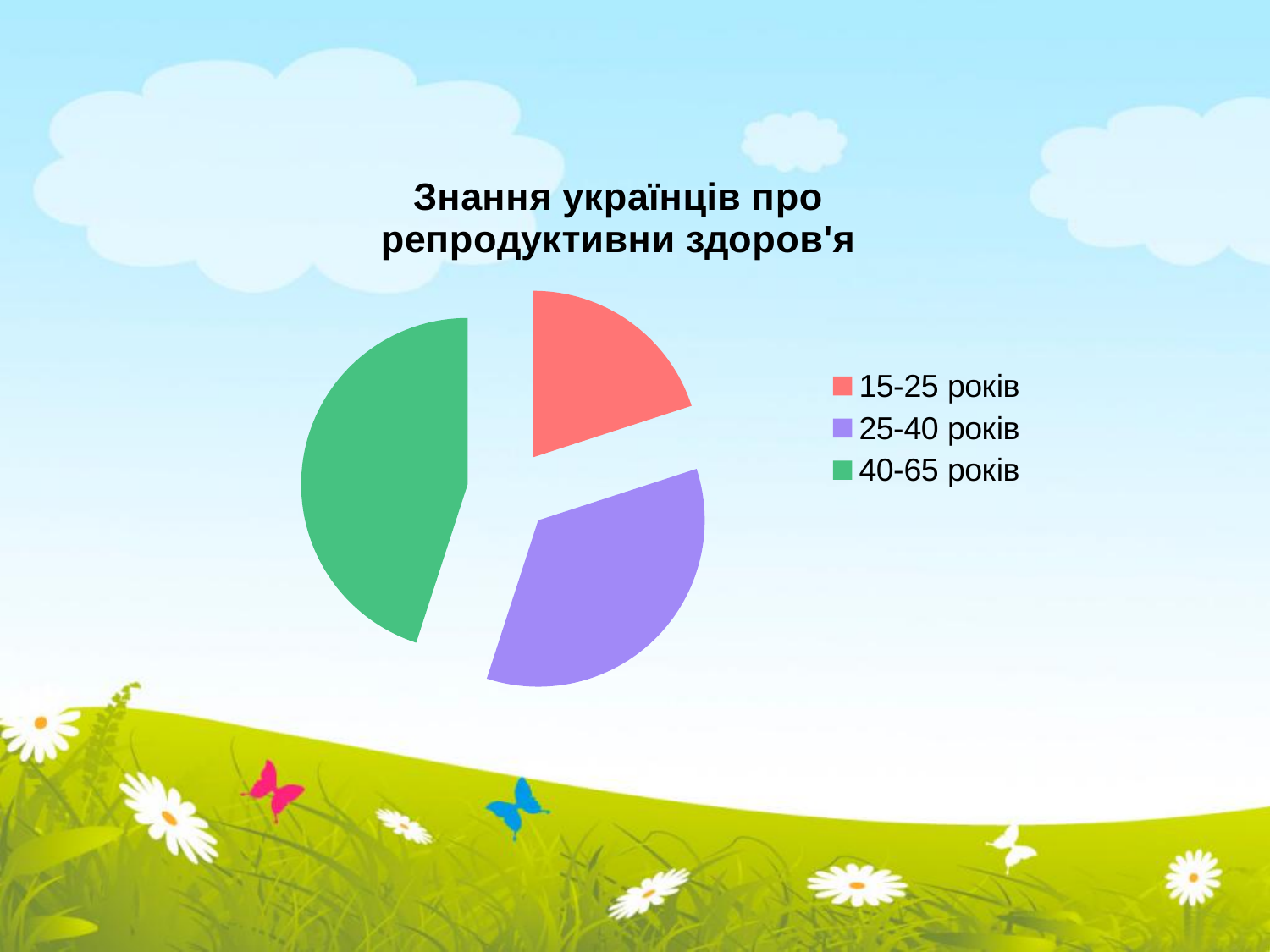
Which slice is larger, 15-25 років or 25-40 років? 25-40 років Which age group has the largest slice of the pie? 40-65 років Which age group has the smallest slice of the pie? 15-25 років Which slice is larger, 15-25 років or 40-65 років? 40-65 років What colour is the slice for 15-25 років? red What is the title of the chart? Знання українців про репродуктивни здоров'я How many slices does the pie chart have? 3 How many entries does the legend list? 3 What kind of chart is shown on the slide? pie chart